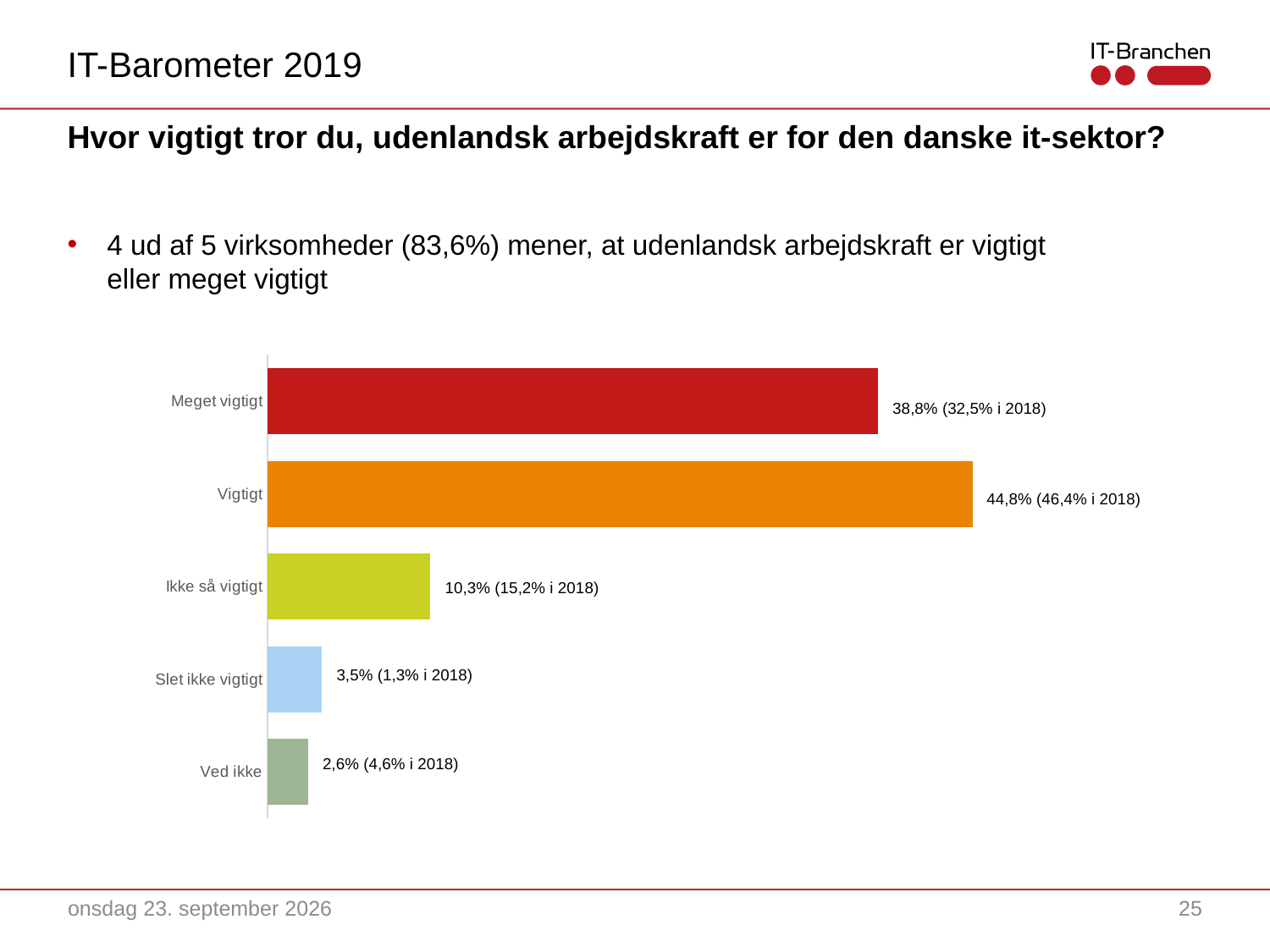
What is the difference between the 2019 values for "Vigtigt" and "Meget vigtigt"? 6,0% Which category has the lowest value in 2019? Ved ikke Which category has the highest value in 2019? Vigtigt Which is larger, the 2019 value for "Slet ikke vigtigt" or the 2019 value for "Ved ikke"? Slet ikke vigtigt What is the value for "Meget vigtigt" in 2019? 38,8% What was the value for "Ved ikke" in 2018? 4,6% What kind of chart is shown on the slide? bar chart How many categories does the chart show? 5 By how much did the value for "Meget vigtigt" increase from 2018 to 2019? 6,3% What was the value for "Ikke så vigtigt" in 2018? 15,2% What is the value for "Slet ikke vigtigt" in 2019? 3,5% What is the value for "Vigtigt" in 2019? 44,8%